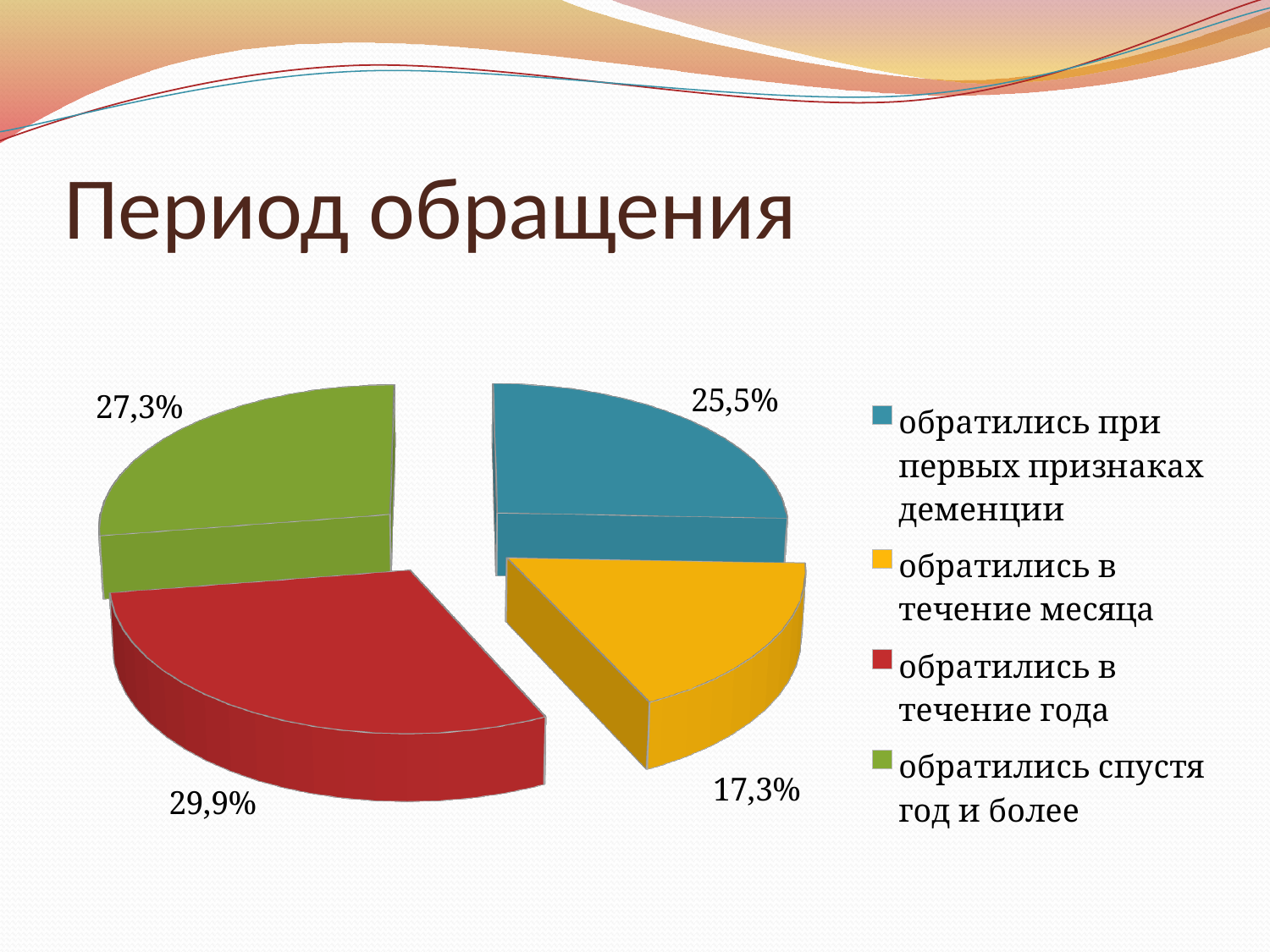
What colour is the slice for "обратились в течение месяца"? Yellow Which is larger: the value for "обратились спустя год и более" or the value for "обратились при первых признаках деменции"? обратились спустя год и более What is the value for "обратились в течение месяца"? 17,3% Which category has the smallest share of the pie? обратились в течение месяца What is the value for "обратились спустя год и более"? 27,3% How many slices does the pie chart have? 4 What is the value for "обратились в течение года"? 29,9% What is the difference between the values for "обратились в течение года" and "обратились в течение месяца"? 12,6% Which category has the largest share of the pie? обратились в течение года What kind of chart is shown on the slide? Pie chart What is the value for "обратились при первых признаках деменции"? 25,5% What is the title of the slide? Период обращения